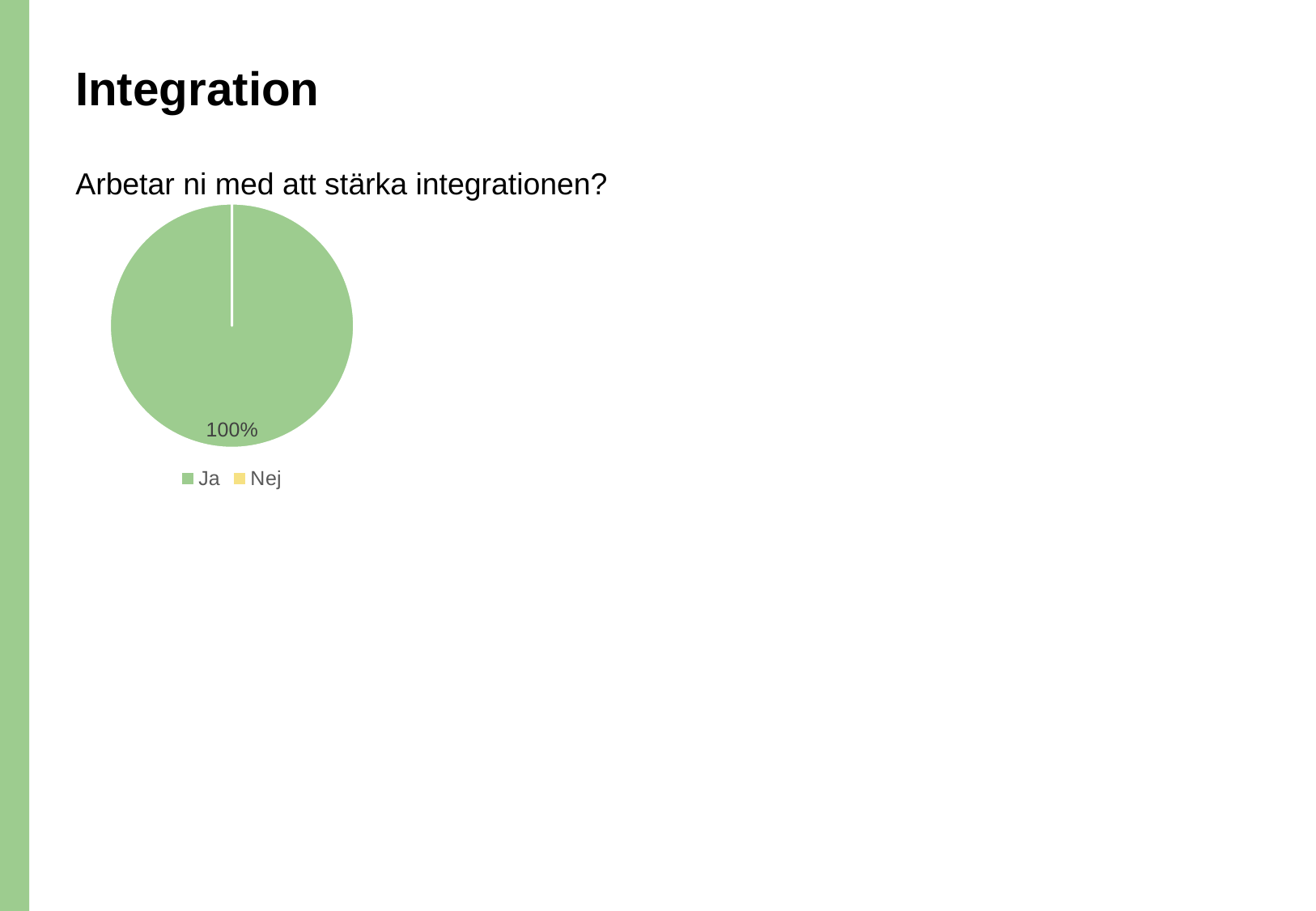
What kind of chart is shown on the slide? pie chart What colour represents "Ja" in the legend? green What question does the chart answer, as written above it? Arbetar ni med att stärka integrationen? Which category has the largest share of the pie? Ja Is the share for "Ja" greater or less than 50%? greater What is the value printed on the pie chart? 100% What share of the pie does "Ja" represent? 100% How many entries does the legend list? 2 Which is larger, the share for "Ja" or the share for "Nej"? Ja